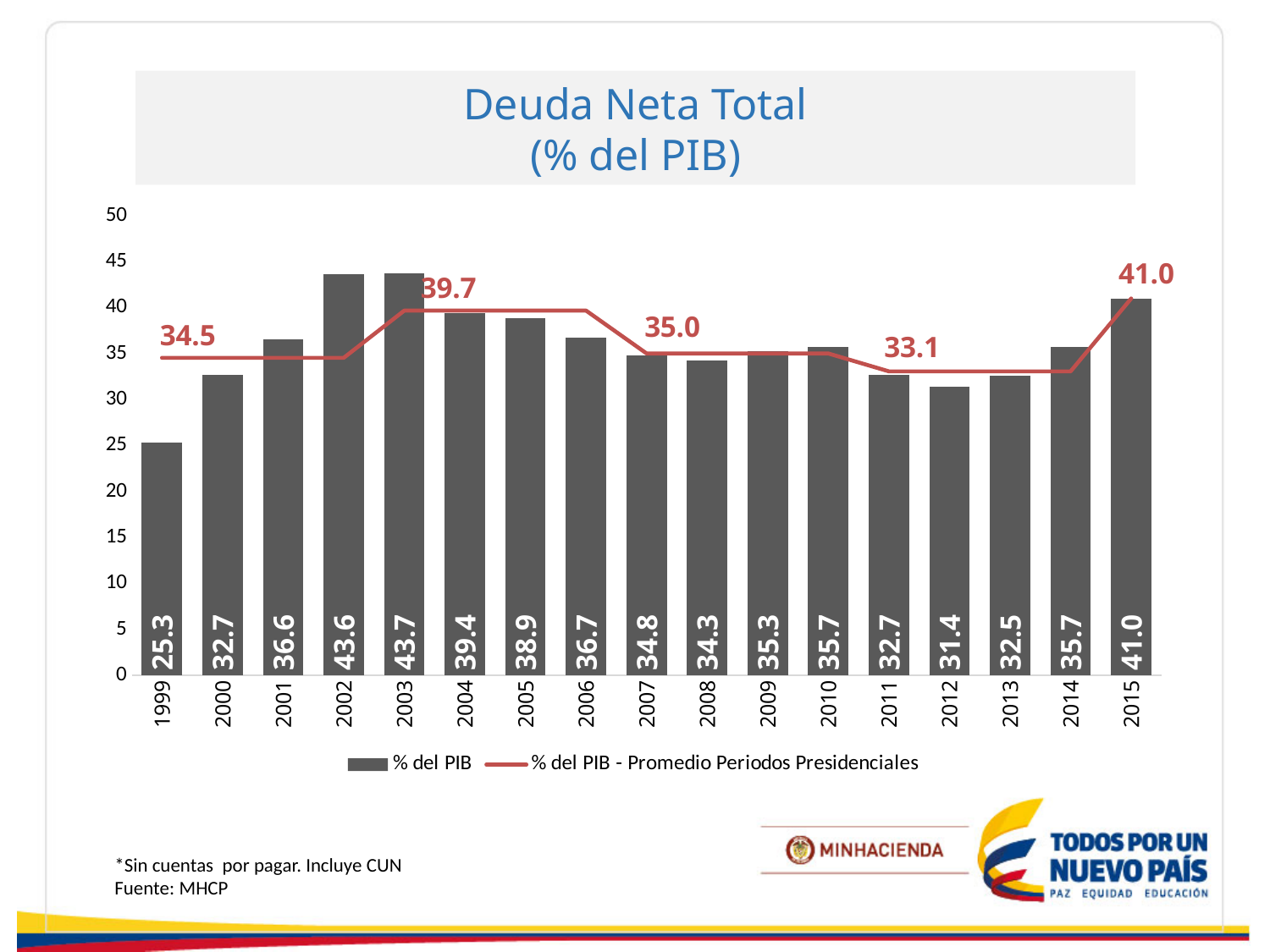
How many years are shown on the x axis? 17 Which year has the lowest value in the bar series? 1999 How many series does the legend list? 2 What is the value for 2012 in the bar series? 31.4 Which year has the highest value in the bar series? 2003 What is the difference between the 2015 value and the 2014 value in the bar series? 5.3 What is the value for 1999 in the bar series? 25.3 What kind of chart is this? Combined bar and line chart What is the value for 2015 in the bar series? 41.0 Which is larger, the value for 2002 or the value for 2004? 2002 What is the title of the chart? Deuda Neta Total (% del PIB) What is the value of the presidential-period average line labelled above 2003? 39.7